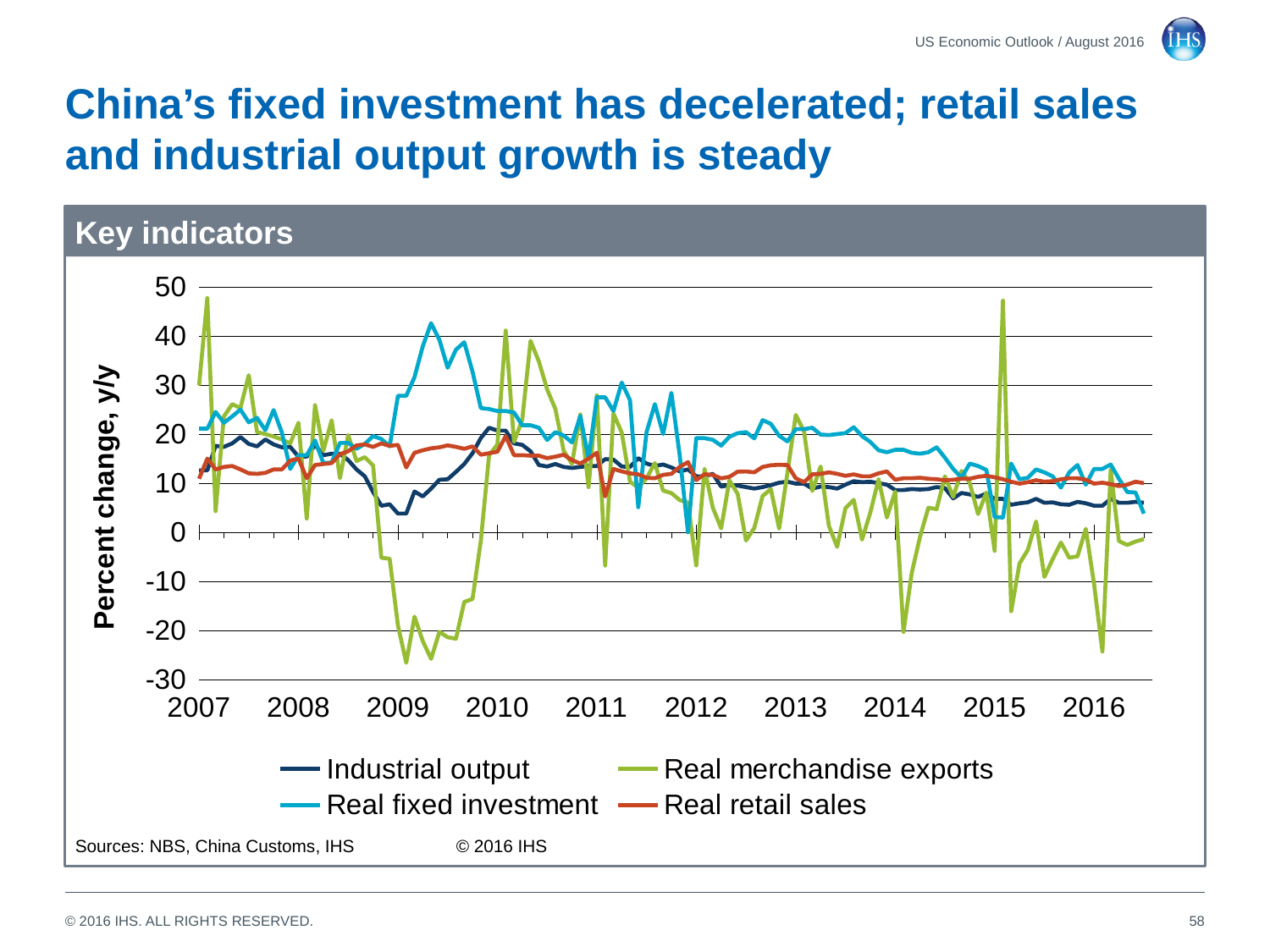
Does Real fixed investment rise or fall from 2013 to 2016? fall Is the lowest value of Real merchandise exports in 2009 greater or less than -20? less Is the value of Industrial output in 2016 greater or less than 10? less How many year labels are shown on the x axis? 10 What are the four series listed in the legend? Industrial output, Real merchandise exports, Real fixed investment, Real retail sales Is the spike in Real merchandise exports in early 2015 greater or less than 40? greater How many series does the legend list? 4 Which series reaches the lowest value on the chart? Real merchandise exports What is the label on the vertical axis? Percent change, y/y What kind of chart is shown on the slide? line chart At the end of 2016, which is higher: Real retail sales or Industrial output? Real retail sales